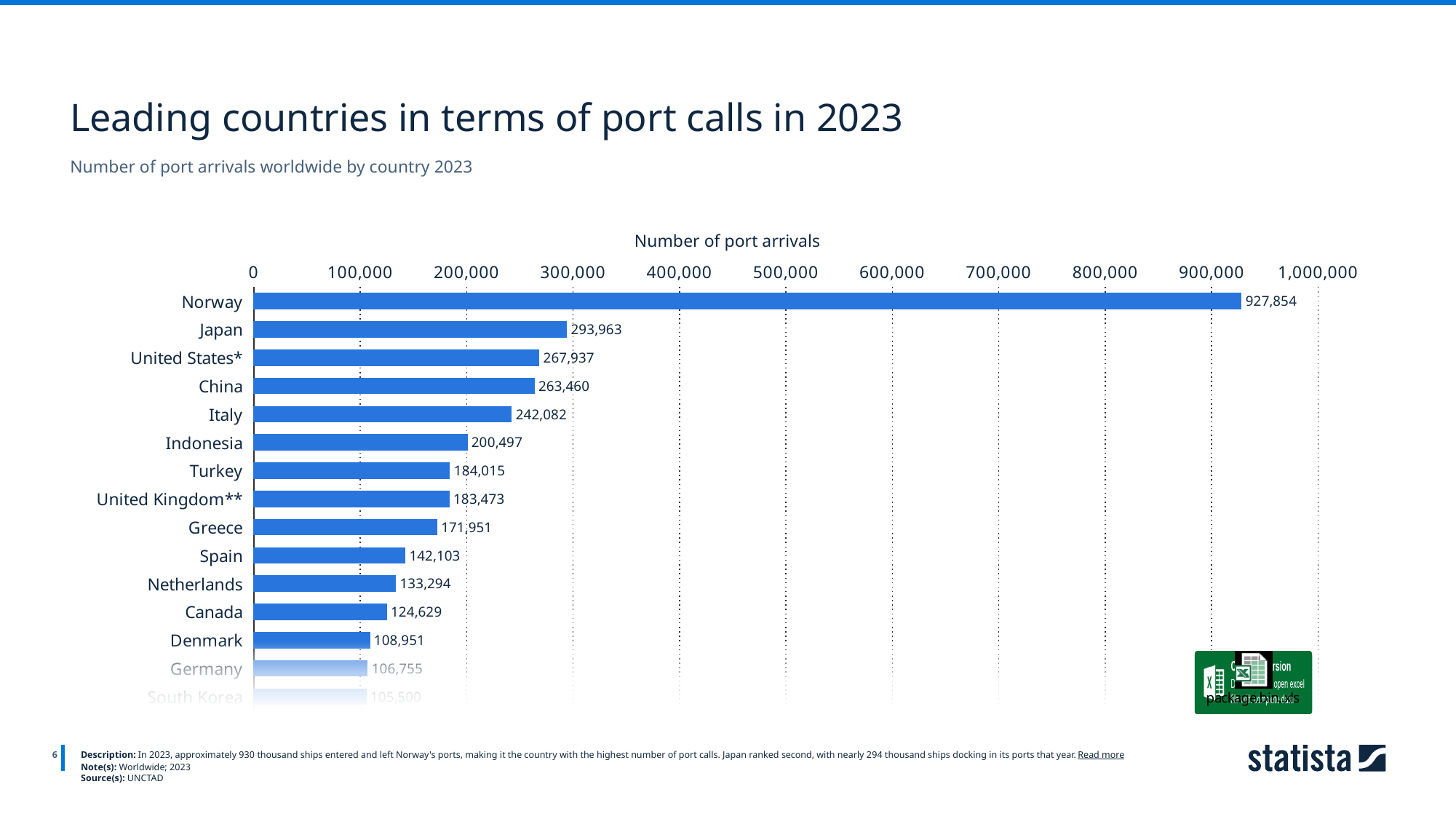
Is the value for Greece greater or less than 200,000? less What is the number of port arrivals for Canada? 124,629 Which country has the highest number of port arrivals? Norway Which has more port arrivals, Spain or Netherlands? Spain What is the title of the horizontal axis of the chart? Number of port arrivals What is the difference in port arrivals between Turkey and United Kingdom**? 542 What kind of chart is shown on the slide? bar chart What is the number of port arrivals for Norway? 927,854 Which has more port arrivals, China or Italy? China What is the number of port arrivals for Italy? 242,082 What is the difference in port arrivals between Norway and Japan? 633,891 What is the number of port arrivals for United Kingdom**? 183,473